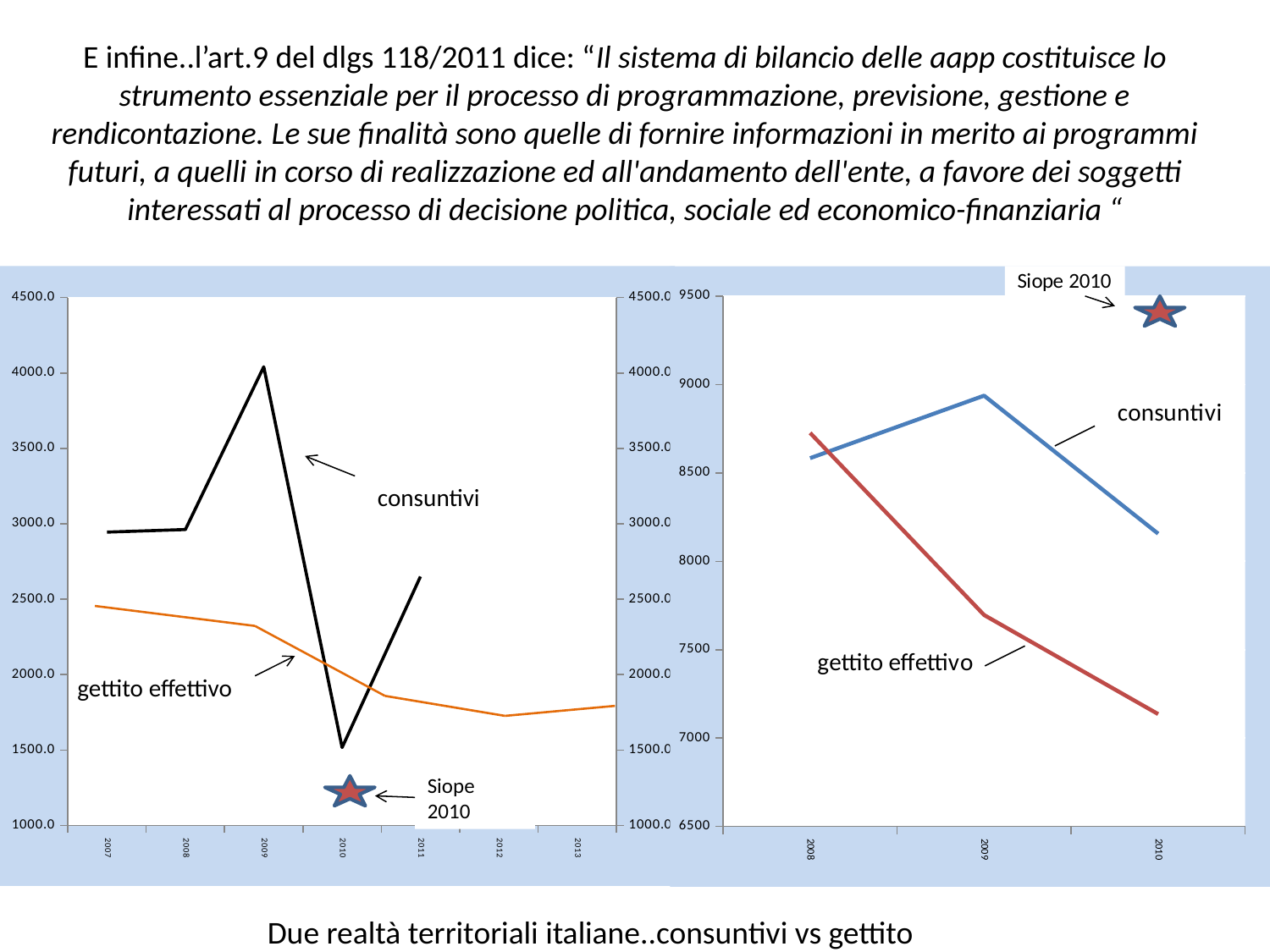
In the left chart, in which year is the consuntivi line at its highest? 2009 In the left chart, is the consuntivi value for 2010 greater or less than 2000.0? less In the left chart, in which year is the consuntivi line at its lowest? 2010 What kind of chart is the chart on the left of the slide? line chart In the left chart, does the gettito effettivo line generally rise or fall from 2007 to 2013? fall In the right chart, which is higher in 2010, consuntivi or gettito effettivo? consuntivi In the left chart, is the consuntivi value for 2009 greater or less than 4000.0? greater In the left chart, how many years are shown on the x axis? 7 In the right chart, is the gettito effettivo value for 2010 greater or less than 7500? less In the right chart, does the gettito effettivo line rise or fall from 2008 to 2010? fall In the right chart, in which year is the consuntivi line at its highest? 2009 In the right chart, how many years are shown on the x axis? 3